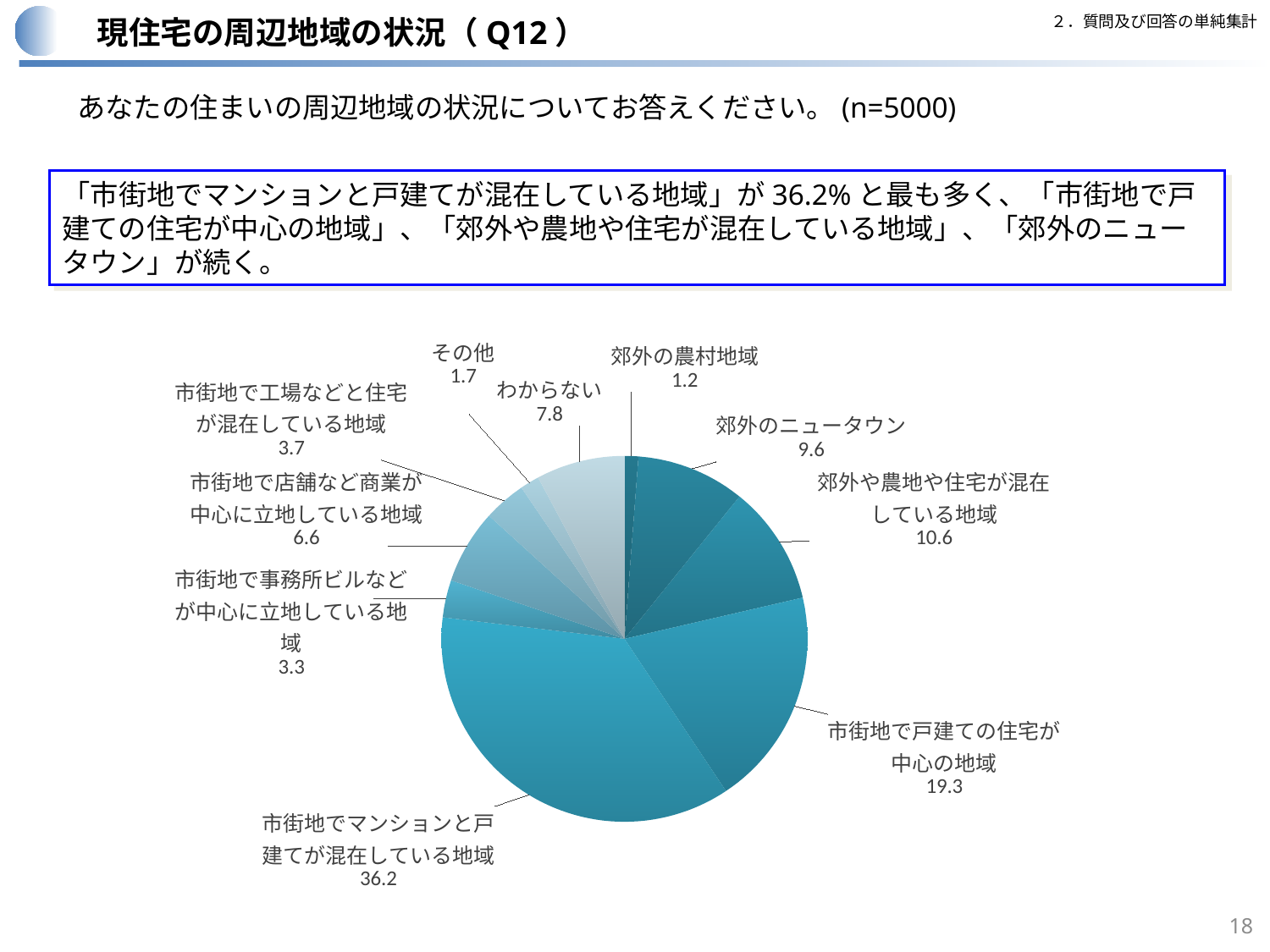
What is the value for わからない? 7.8 Which category has the largest slice of the pie? 市街地でマンションと戸建てが混在している地域 How many categories are shown in the pie chart? 10 What is the value for 郊外のニュータウン? 9.6 Which is larger, the value for 郊外や農地や住宅が混在している地域 or the value for 郊外のニュータウン? 郊外や農地や住宅が混在している地域 What is the difference between the values for 市街地でマンションと戸建てが混在している地域 and 市街地で戸建ての住宅が中心の地域? 16.9 What is the value for 市街地で戸建ての住宅が中心の地域? 19.3 What kind of chart is shown on the slide? Pie chart Which category has the smallest slice of the pie? 郊外の農村地域 What is the sample size (n) stated on the slide for this question? n=5000 What is the difference between the values for 市街地で店舗など商業が中心に立地している地域 and 市街地で事務所ビルなどが中心に立地している地域? 3.3 What is the value for 市街地でマンションと戸建てが混在している地域? 36.2